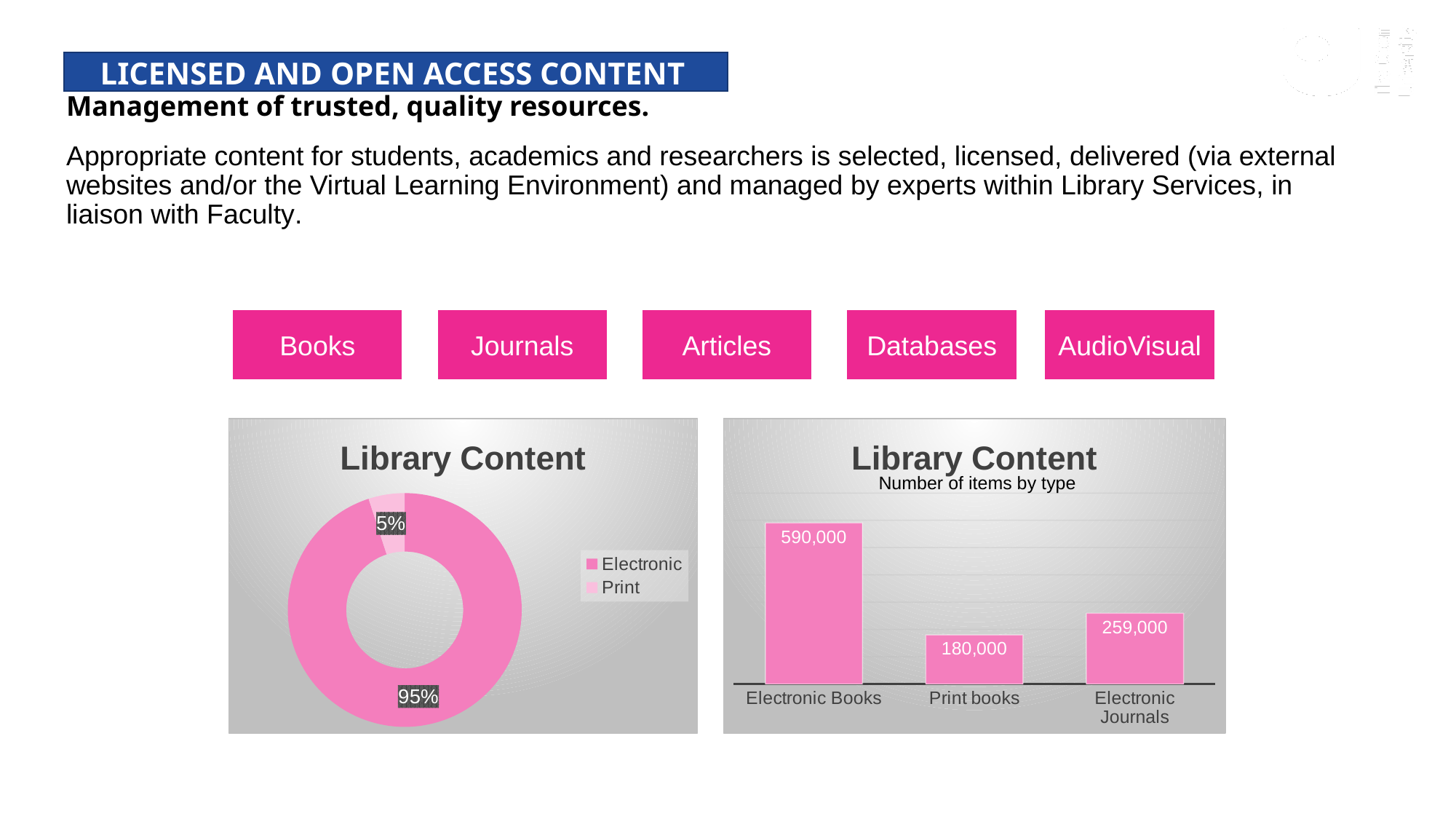
In the doughnut chart on the left, what share of library content is Electronic? 95% In the bar chart on the right, what is the value for Print books? 180,000 In the doughnut chart on the left, how many entries does the legend list? 2 What kind of chart is the left-hand 'Library Content' chart? Doughnut chart In the bar chart on the right, which category has the highest value? Electronic Books In the bar chart on the right, which category has the lowest value? Print books In the doughnut chart on the left, which segment is larger, Electronic or Print? Electronic In the bar chart on the right, what is the difference between Electronic Books and Electronic Journals? 331,000 In the bar chart on the right, what is the value for Electronic Journals? 259,000 In the bar chart on the right, what is the value for Electronic Books? 590,000 In the doughnut chart on the left, what share of library content is Print? 5% In the bar chart on the right, what is the subtitle shown under the chart title? Number of items by type